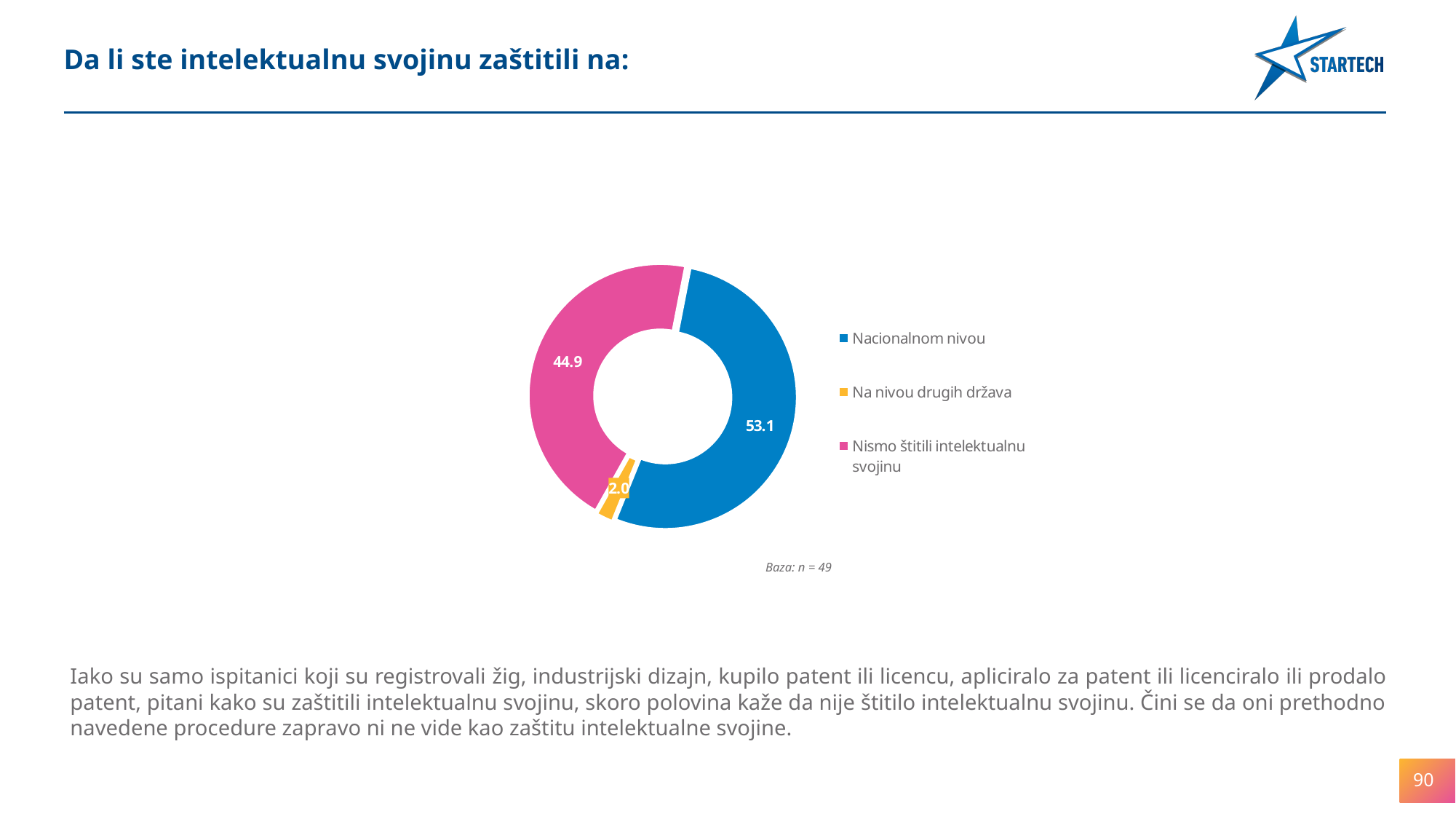
What is the difference between the values for "Nismo štitili intelektualnu svojinu" and "Na nivou drugih država"? 42.9 Which category has the smallest slice? Na nivou drugih država What is the value for "Na nivou drugih država"? 2.0 What kind of chart is shown on the slide? Pie chart (doughnut) How many categories does the chart show? 3 What is the difference between the values for "Nacionalnom nivou" and "Nismo štitili intelektualnu svojinu"? 8.2 What is the value for "Nacionalnom nivou"? 53.1 What is the value for "Nismo štitili intelektualnu svojinu"? 44.9 Which category has the largest slice? Nacionalnom nivou What is the base (n) stated below the chart? n = 49 Which is larger, the value for "Nacionalnom nivou" or the value for "Nismo štitili intelektualnu svojinu"? Nacionalnom nivou What colour is the slice for "Nismo štitili intelektualnu svojinu"? Pink